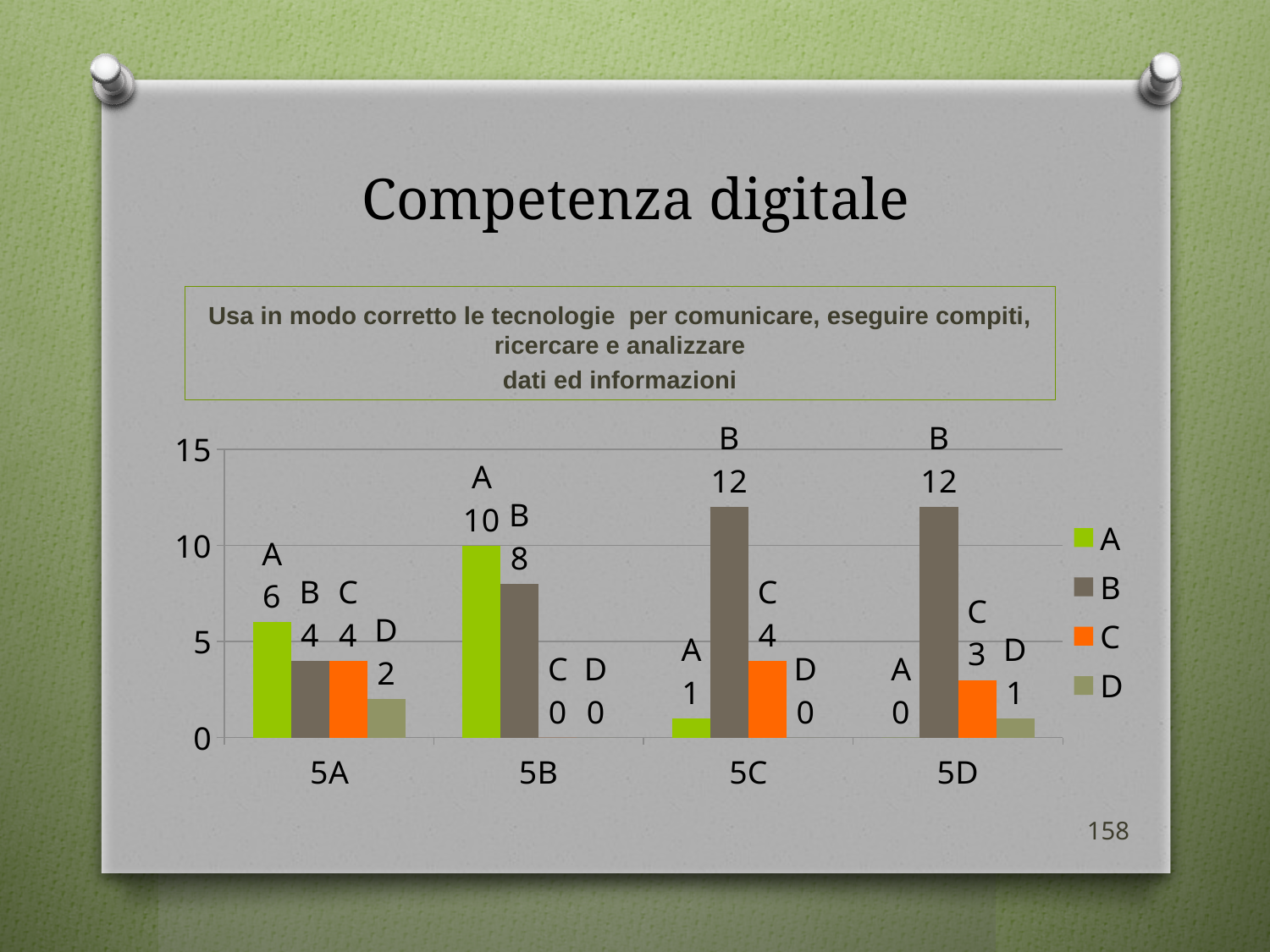
What is the value of series A for class 5A? 6 Which series has the highest value for class 5B? A What is the value of series D for class 5B? 0 How many series does the legend list? 4 What is the value of series C for class 5D? 3 What is the title of the slide containing the chart? Competenza digitale Which series has the lowest value for class 5D? A How many classes (categories) are shown on the x axis? 4 What kind of chart is shown on the slide? bar chart What is the difference between series B and series A for class 5B? 2 Which is larger for class 5C: series C or series A? C What is the value of series B for class 5C? 12